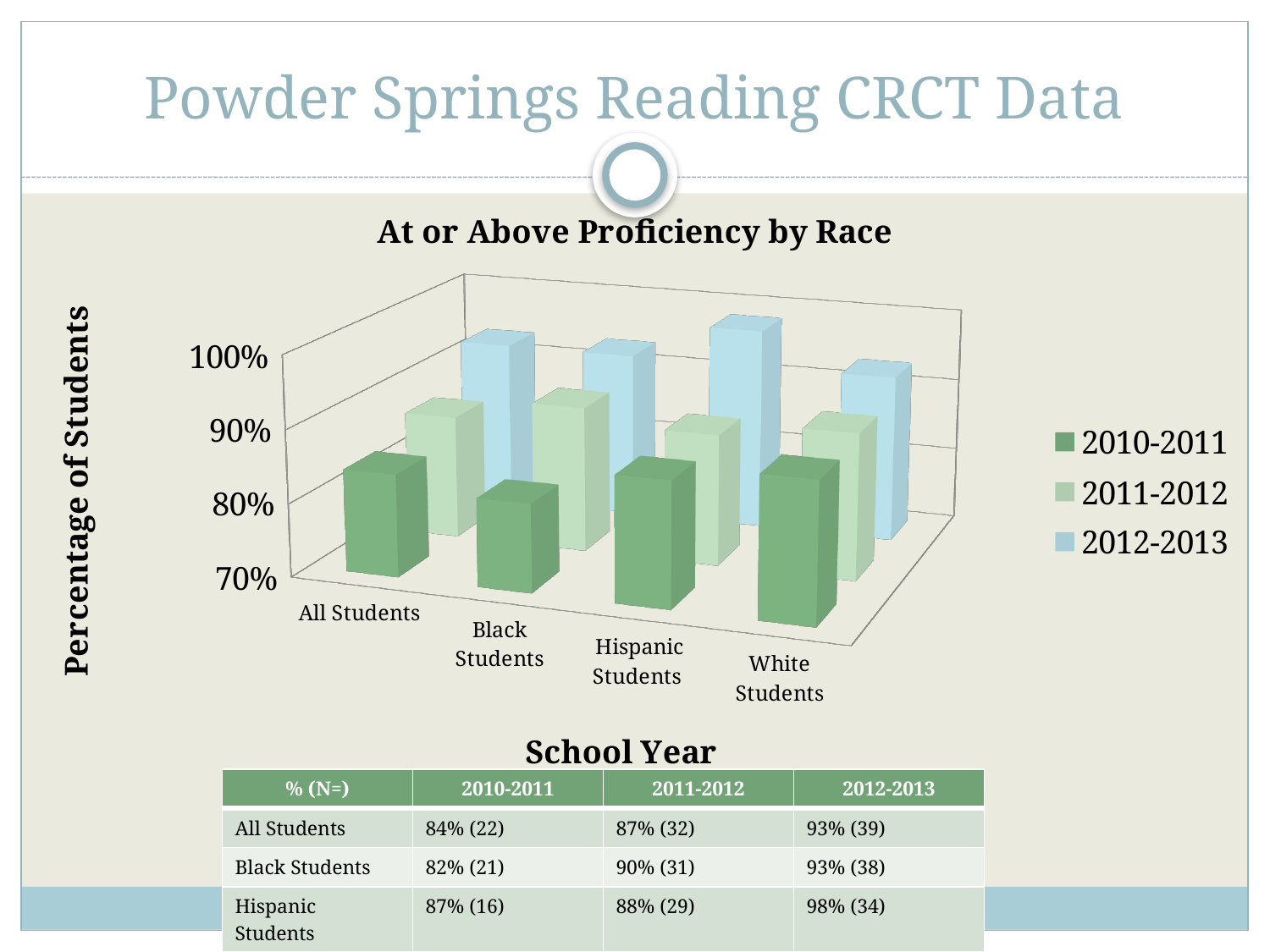
What is the title of the chart? At or Above Proficiency by Race How many series does the legend list? 3 What kind of chart is shown on the slide? bar chart Do the values for All Students rise or fall from 2010-2011 to 2012-2013? rise What percentage of All Students were at or above proficiency in 2012-2013? 93% What percentage of Black Students were at or above proficiency in 2010-2011? 82% What percentage of Hispanic Students were at or above proficiency in 2012-2013? 98% How many student groups are shown on the x axis of the chart? 4 By how many percentage points did the Hispanic Students value increase from 2011-2012 to 2012-2013? 10 percentage points In which school year did Black Students have their highest value? 2012-2013 In 2011-2012, which had the higher value: All Students or Black Students? Black Students Is the value for Hispanic Students in 2012-2013 greater or less than 90%? greater